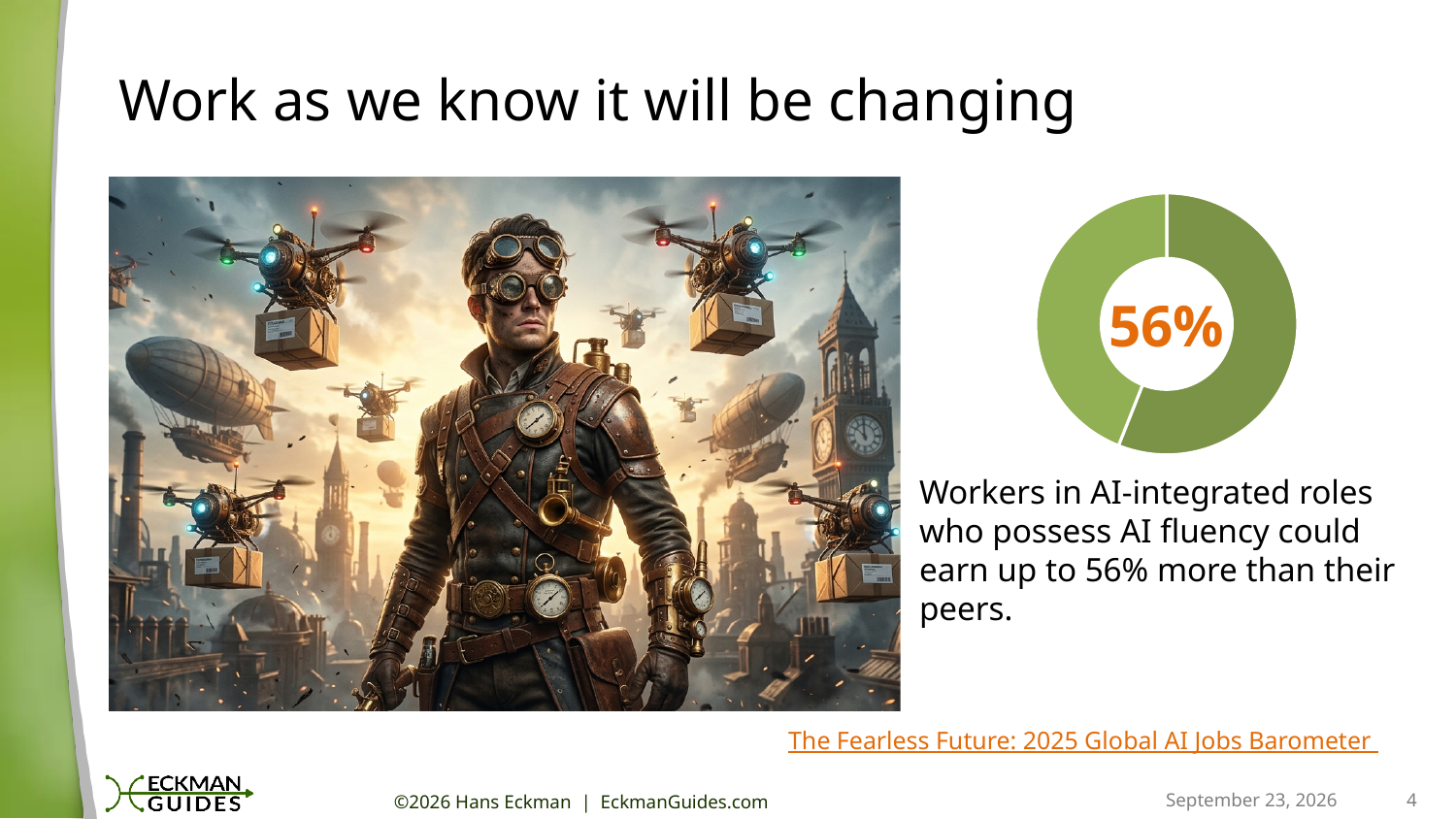
What kind of chart is shown on the right side of the slide? doughnut chart What share of the doughnut chart does the larger (darker green) slice represent? 56% What value is printed in the centre of the doughnut chart? 56% Is the value labelled on the doughnut chart greater or less than 50%? greater How many slices does the doughnut chart have? 2 Which slice of the doughnut chart is larger, the darker green one or the lighter green one? the darker green slice Does the doughnut chart include a legend? No What colour family are the slices of the doughnut chart? green